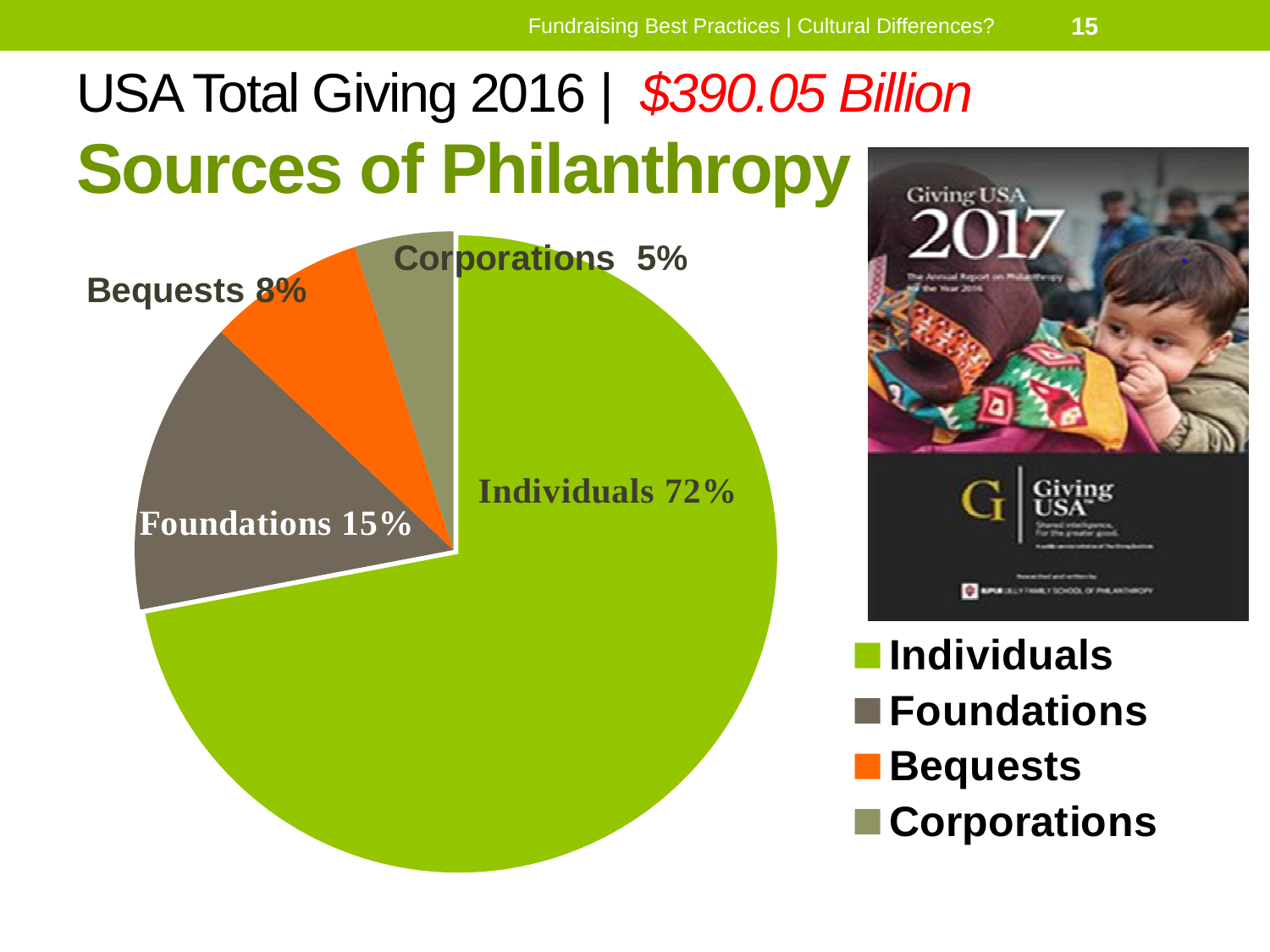
What is the value shown for Bequests? 8% What is the difference in percentage points between Bequests and Corporations? 3 What colour is the Bequests slice in the pie chart? Orange What is the difference in percentage points between Individuals and Foundations? 57 What share of the pie does Individuals account for? 72% Which source has the largest share of the pie? Individuals What is the value shown for Foundations? 15% How many slices does the pie chart have? 4 Which source has the smallest share of the pie? Corporations What is the value shown for Corporations? 5% Which is larger, the share for Foundations or the share for Bequests? Foundations What kind of chart is shown on the slide? Pie chart